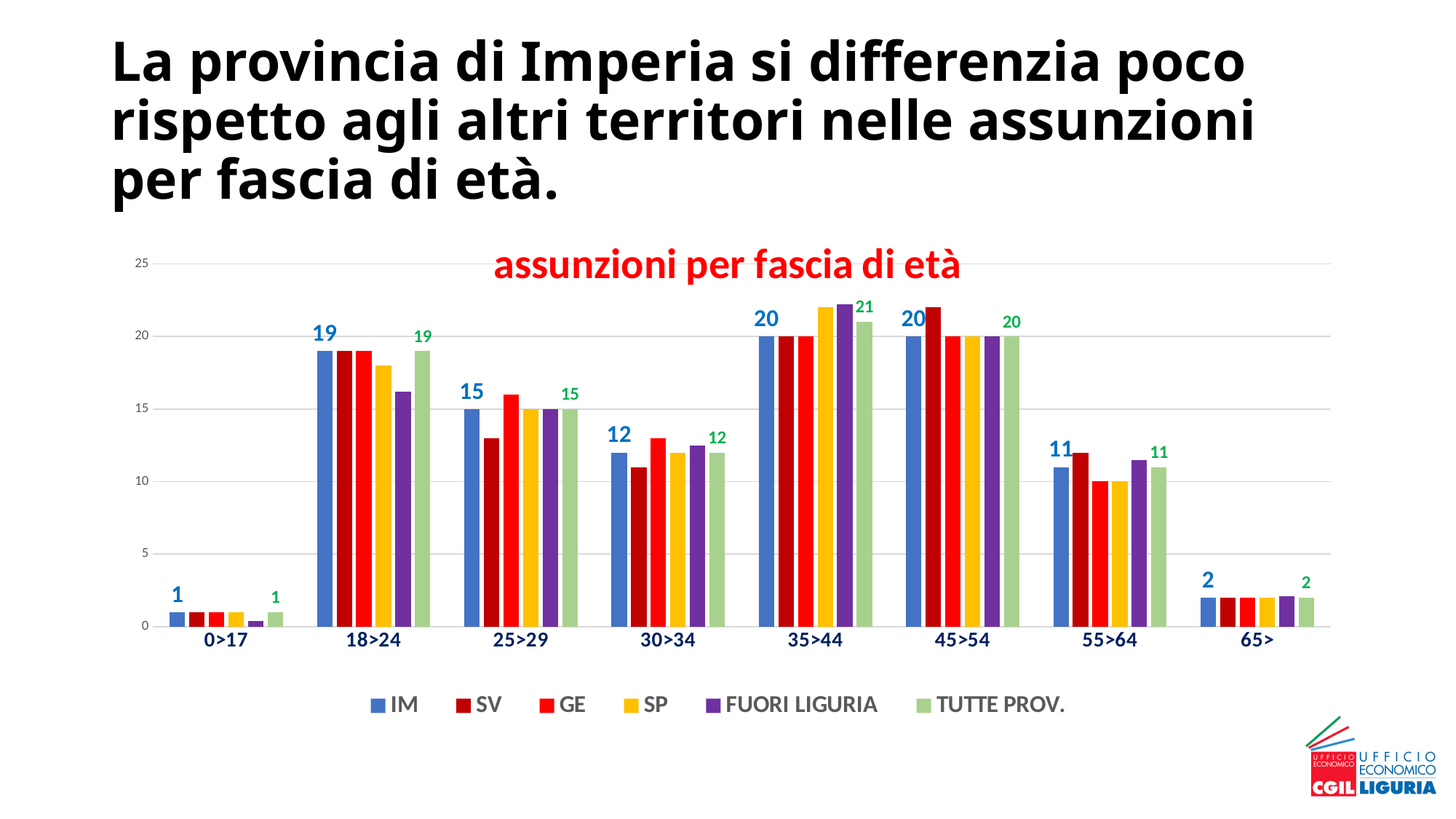
What is the difference between the TUTTE PROV. value and the IM value for 35>44? 1 How many series does the legend list? 6 How many age groups are shown on the x axis? 8 Which age group has the highest value for TUTTE PROV.? 35>44 What is the difference between the IM values for 18>24 and 25>29? 4 What is the title of the chart? assunzioni per fascia di età What kind of chart is shown on the slide? bar chart Which is larger for IM: the value for 30>34 or the value for 55>64? 30>34 Is the value for SV in the 45>54 age group greater or less than 20? greater What is the value for TUTTE PROV. in the 35>44 age group? 21 Which age group has the lowest value for IM? 0>17 What is the value for IM in the 18>24 age group? 19